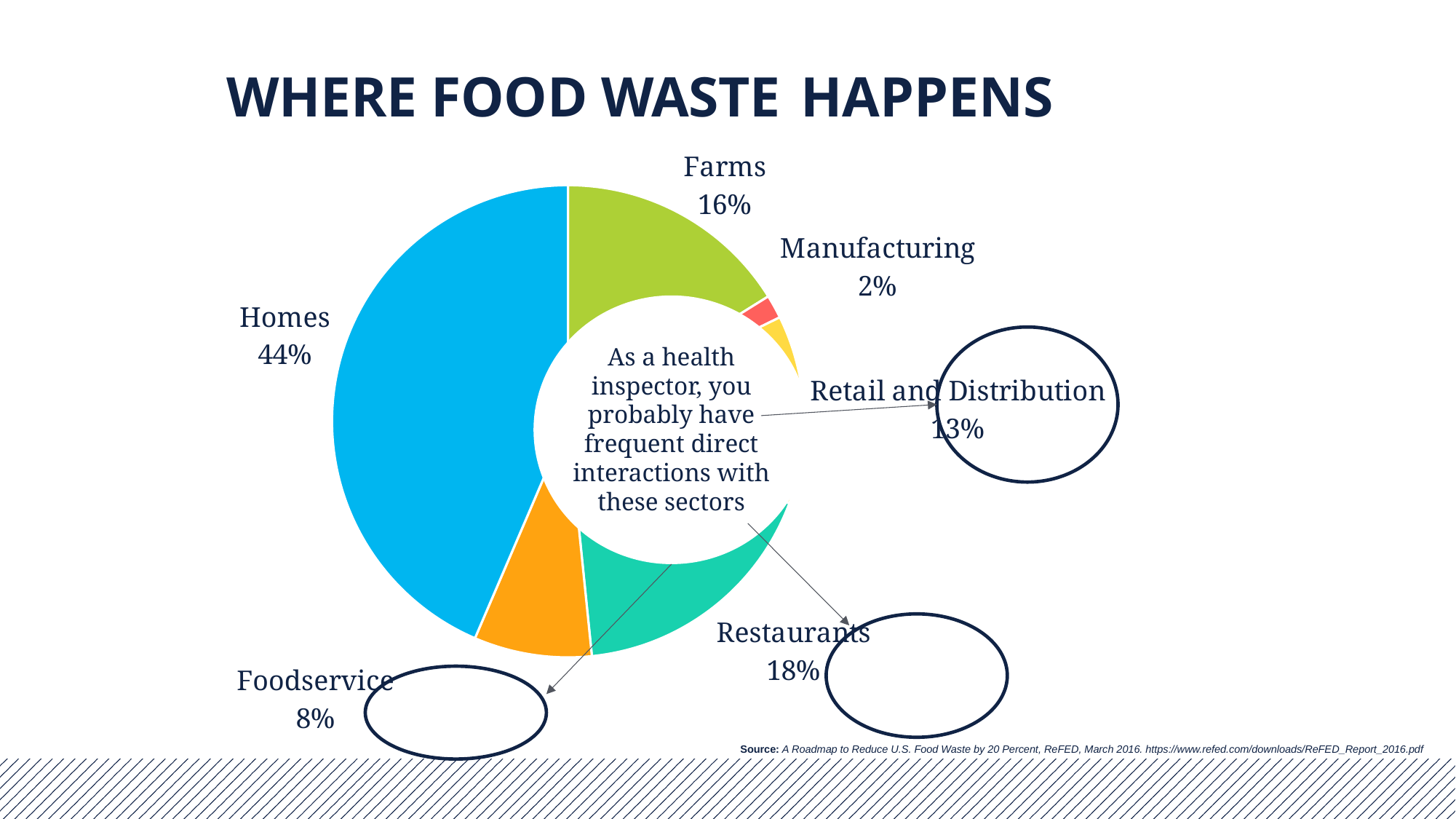
How many percentage points larger is the Homes share than the Restaurants share? 26 percentage points What share of food waste happens in Foodservice? 8% What share of food waste happens on Farms? 16% Which sector accounts for the smallest share of food waste? Manufacturing What share of food waste happens in Homes? 44% How many sectors are shown in the pie chart? 6 Which has a larger share of food waste, Farms or Restaurants? Restaurants What kind of chart is shown on the slide? Pie chart What share of food waste happens in Manufacturing? 2% What share of food waste happens in Retail and Distribution? 13% What share of food waste happens in Restaurants? 18% Which sector accounts for the largest share of food waste? Homes